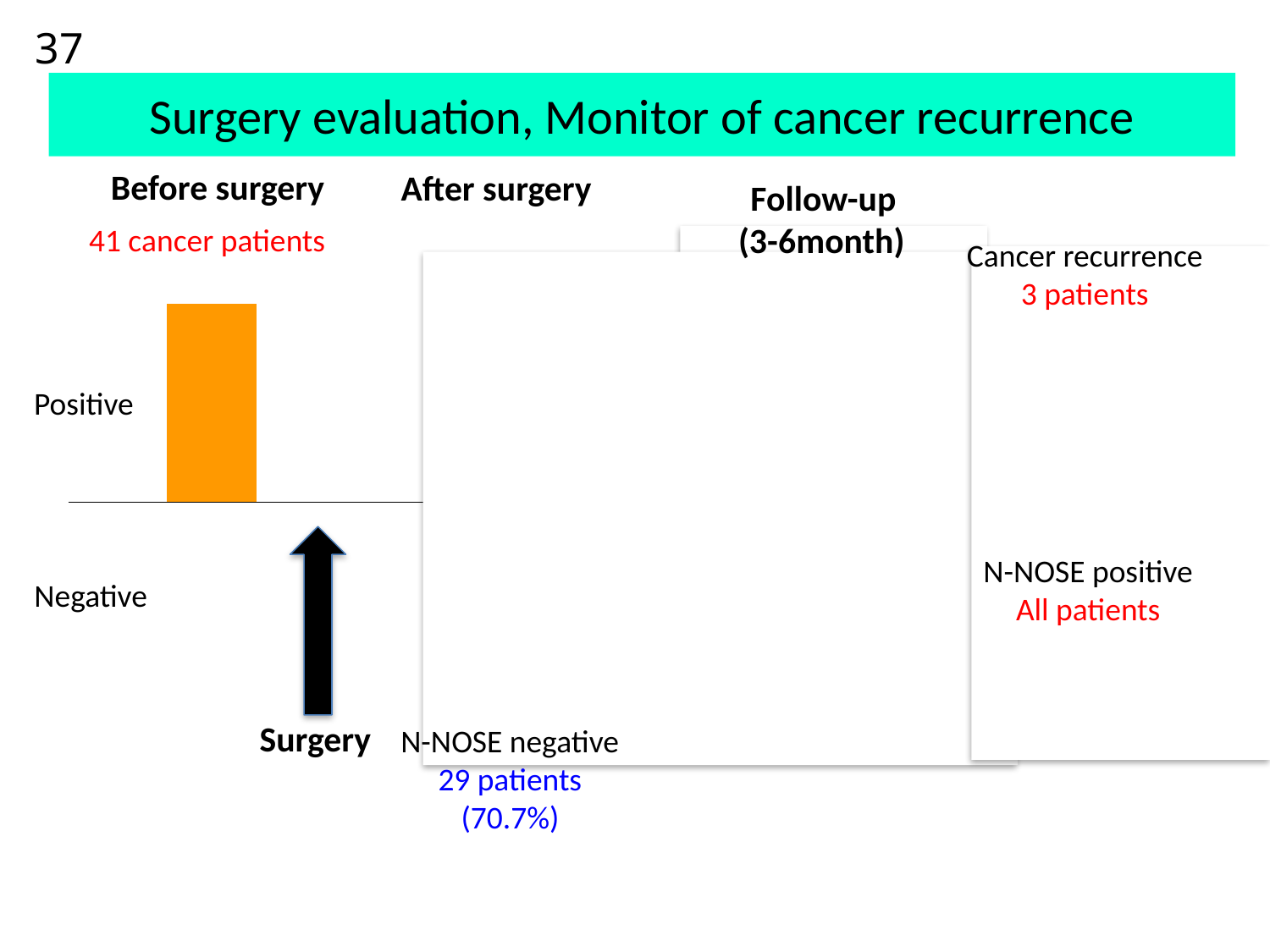
How many bars are visible in the chart? 1 How many cancer patients are stated for the 'Before surgery' stage? 41 cancer patients What percentage is given for the N-NOSE negative patients after surgery? 70.7% What is the follow-up period stated on the slide? 3-6month How many patients are stated under 'Cancer recurrence' at follow-up? 3 patients What is the title shown in the banner above the chart? Surgery evaluation, Monitor of cancer recurrence What colour is the bar shown under 'Before surgery'? orange Is the 'Before surgery' bar in the Positive or the Negative region of the chart? Positive What kind of chart is shown on the slide? bar chart What are the two labels on the vertical axis of the chart? Positive and Negative How many patients are labelled as N-NOSE negative after surgery? 29 patients